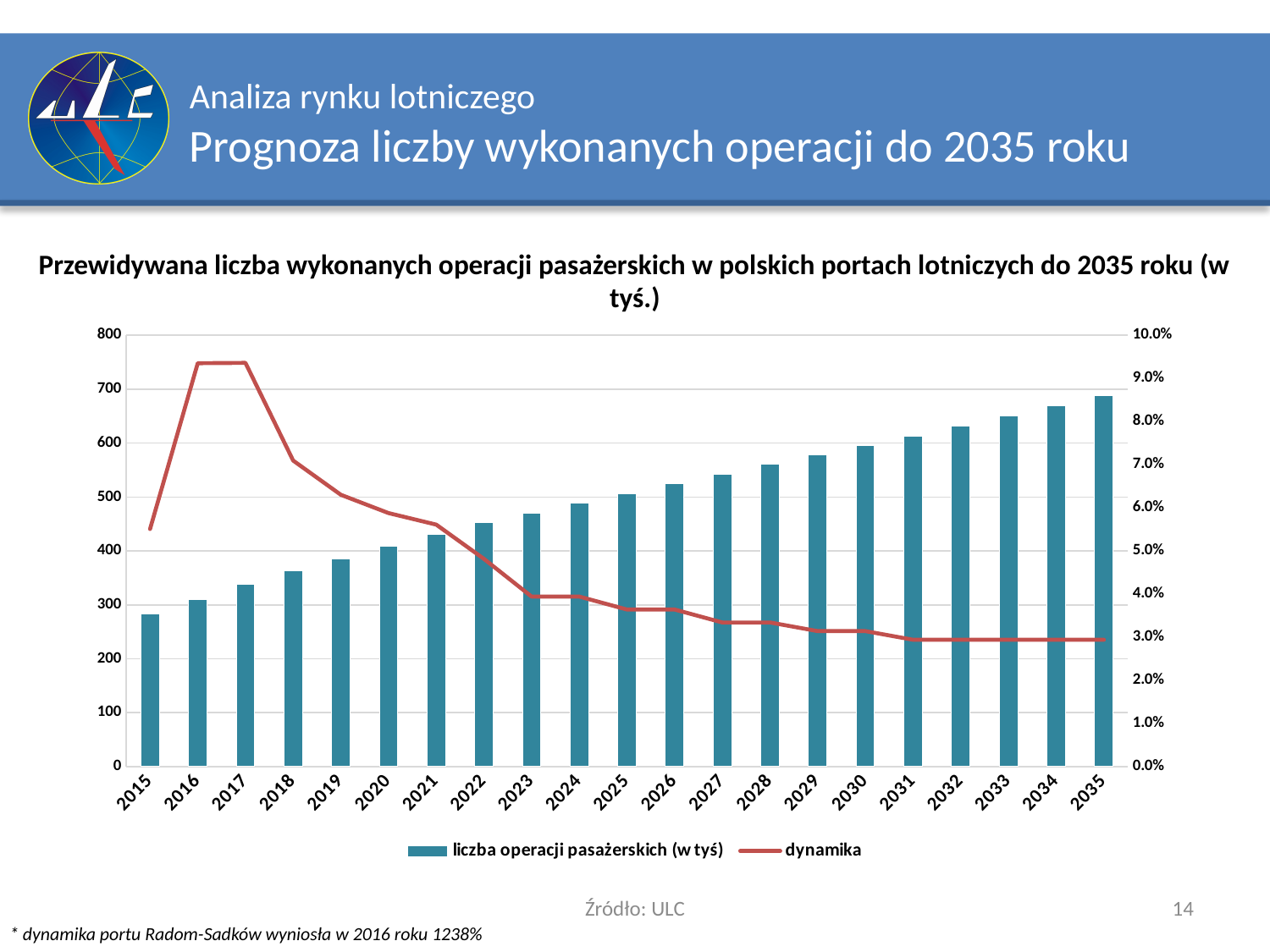
What kind of chart is used for the series 'dynamika'? line chart Is the value for 'dynamika' in 2025 greater or less than 4.0%? less Is the value for 'liczba operacji pasażerskich (w tyś)' in 2015 greater or less than 300? less What is the highest tick shown on the right-hand axis? 10.0% Do the values for 'liczba operacji pasażerskich (w tyś)' rise or fall from 2015 to 2035? rise Which year has the lowest value for 'liczba operacji pasażerskich (w tyś)'? 2015 Does the 'dynamika' line rise or fall from 2017 to 2035? fall How many series does the legend list? 2 What kind of chart is used for the series 'liczba operacji pasażerskich (w tyś)'? bar chart How many years are shown on the x axis? 21 Which year has the highest value for 'liczba operacji pasażerskich (w tyś)'? 2035 Is the value for 'liczba operacji pasażerskich (w tyś)' in 2035 greater or less than 600? greater